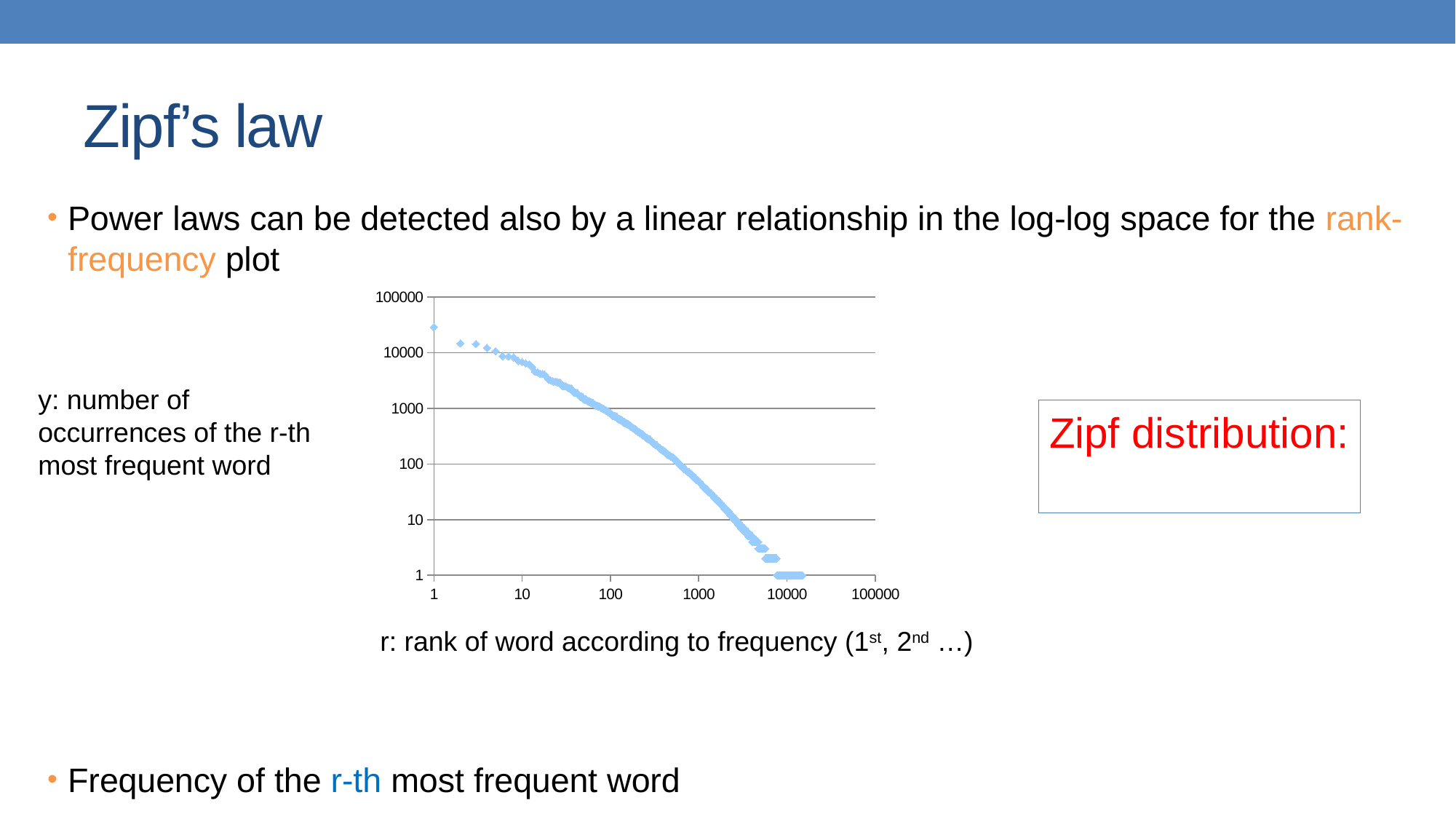
What is the highest tick value shown on the y axis? 100000 Is the number of occurrences for the word at rank 1 greater or less than 10000? greater Is the number of occurrences for the word at rank 10000 greater or less than 10? less Do the plotted values rise or fall as the rank increases along the x axis? fall Is the number of occurrences for the word at rank 1000 greater or less than 1000? less What does the x axis of the chart represent? r: rank of word according to frequency What kind of chart is shown on the slide? scatter plot At which rank is the number of occurrences highest? 1 Which has more occurrences, the word at rank 10 or the word at rank 1000? rank 10